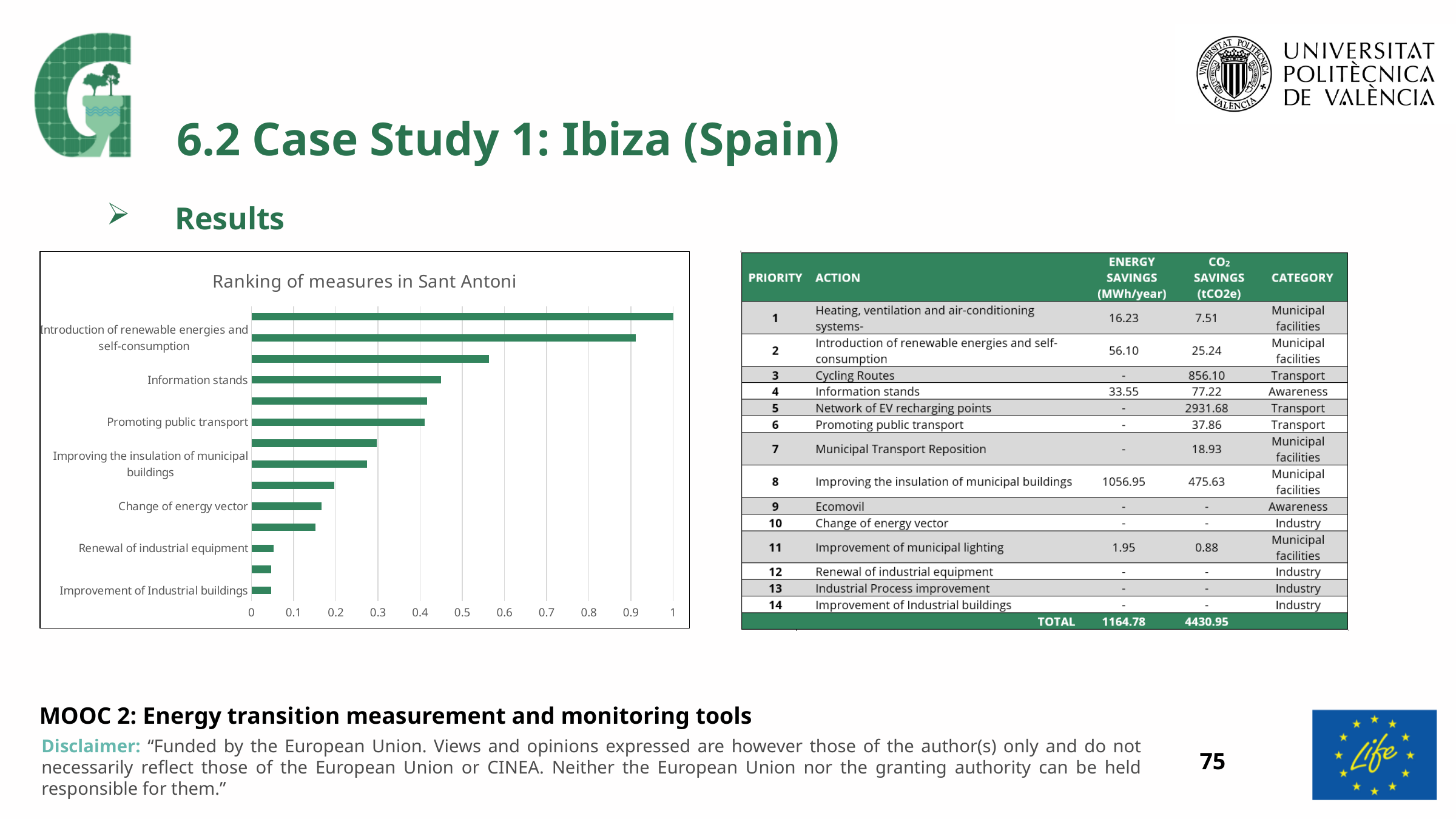
What is the title of the chart on the slide? Ranking of measures in Sant Antoni Is the value for Introduction of renewable energies and self-consumption greater or less than 0.8? greater Is the value for Information stands greater or less than 0.5? less Is the value for Change of energy vector greater or less than 0.2? less Which has the larger value, Information stands or Improving the insulation of municipal buildings? Information stands How many bars are plotted in the chart? 14 Which has the larger value, Change of energy vector or Improvement of Industrial buildings? Change of energy vector Do the bars get longer or shorter going from the top of the chart to the bottom? shorter Among the labelled categories in the chart, which has the longest bar? Introduction of renewable energies and self-consumption What kind of chart is shown on the slide? Bar chart